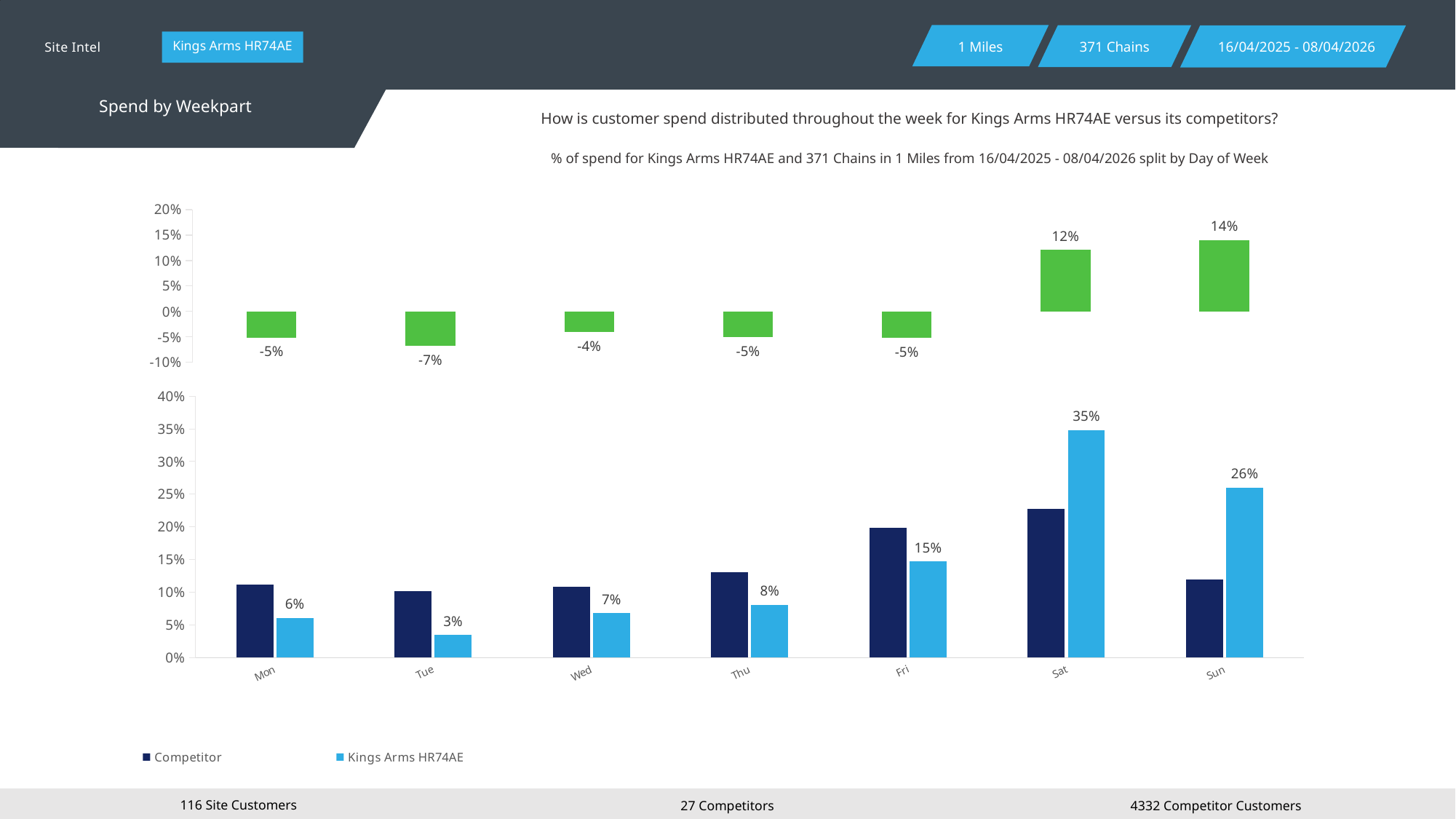
In the bottom chart, which is larger on Fri: the Competitor value or the Kings Arms HR74AE value? Competitor In the top chart, what is the value shown for Tue? -7% In the bottom chart, what is the value for Kings Arms HR74AE on Sat? 35% How many series does the legend of the bottom chart list? 2 In the bottom chart, which day has the highest value for Kings Arms HR74AE? Sat In the bottom chart, what is the difference between the Kings Arms HR74AE values for Sat and Sun? 9% In the bottom chart, what is the value for Kings Arms HR74AE on Tue? 3% In the top chart, what is the value shown for Sun? 14% In the bottom chart, which day has the lowest value for Kings Arms HR74AE? Tue How many days of the week are shown on the x axis of the bottom chart? 7 What kind of chart is the bottom chart? Bar chart In the bottom chart, is the Competitor value for Sat greater or less than 20%? greater